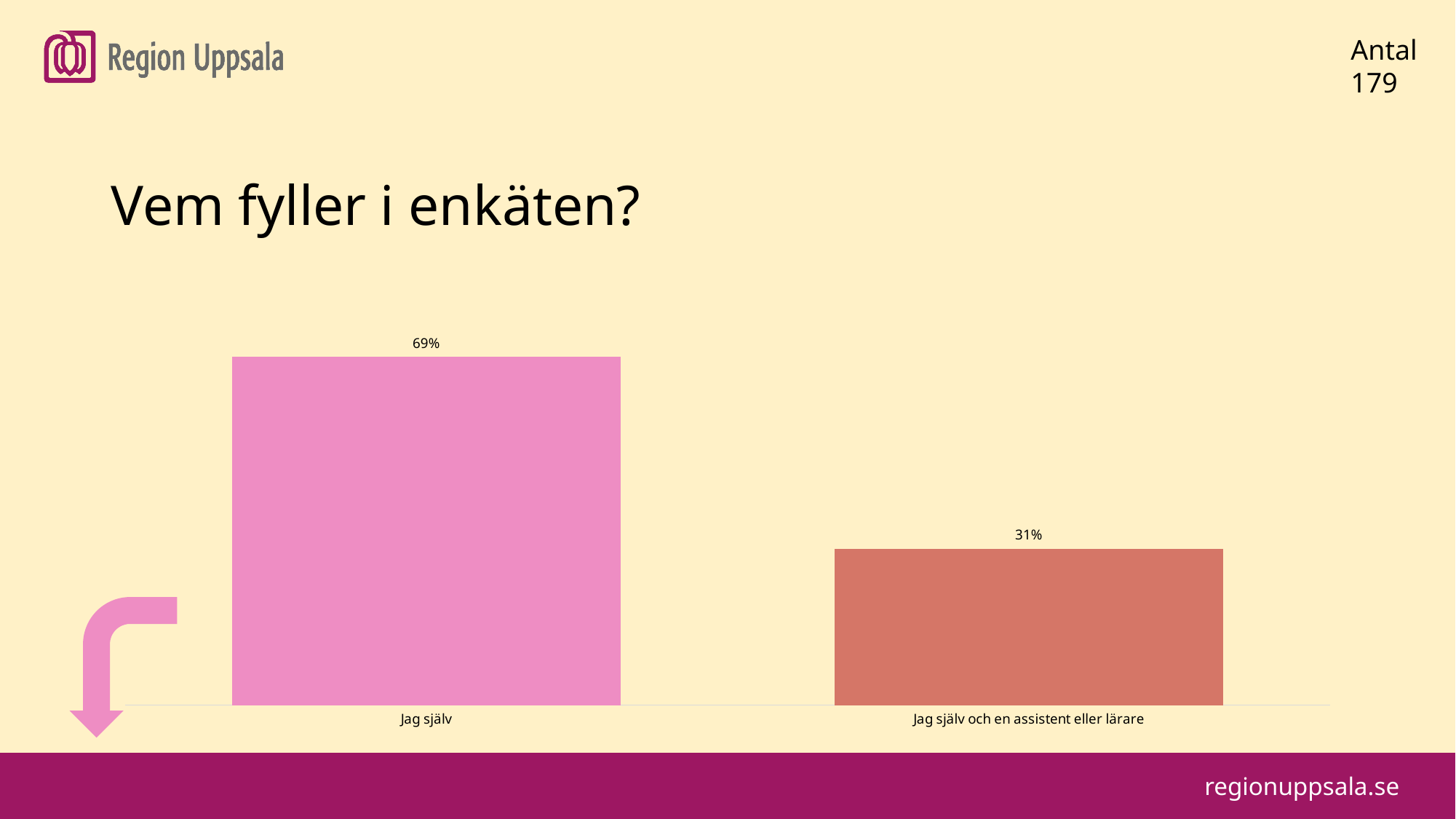
Which is larger: the value for "Jag själv" or the value for "Jag själv och en assistent eller lärare"? Jag själv What is the difference between the values for "Jag själv" and "Jag själv och en assistent eller lärare"? 38% What number is shown next to "Antal" in the top right corner of the slide? 179 What is the value for "Jag själv och en assistent eller lärare"? 31% What kind of chart is shown on the slide? Bar chart What is the title of the slide above the chart? Vem fyller i enkäten? Which category has the lowest value? Jag själv och en assistent eller lärare Which category has the highest value? Jag själv What is the value for "Jag själv"? 69% What is the total of the two values shown in the chart? 100% How many categories are shown in the chart? 2